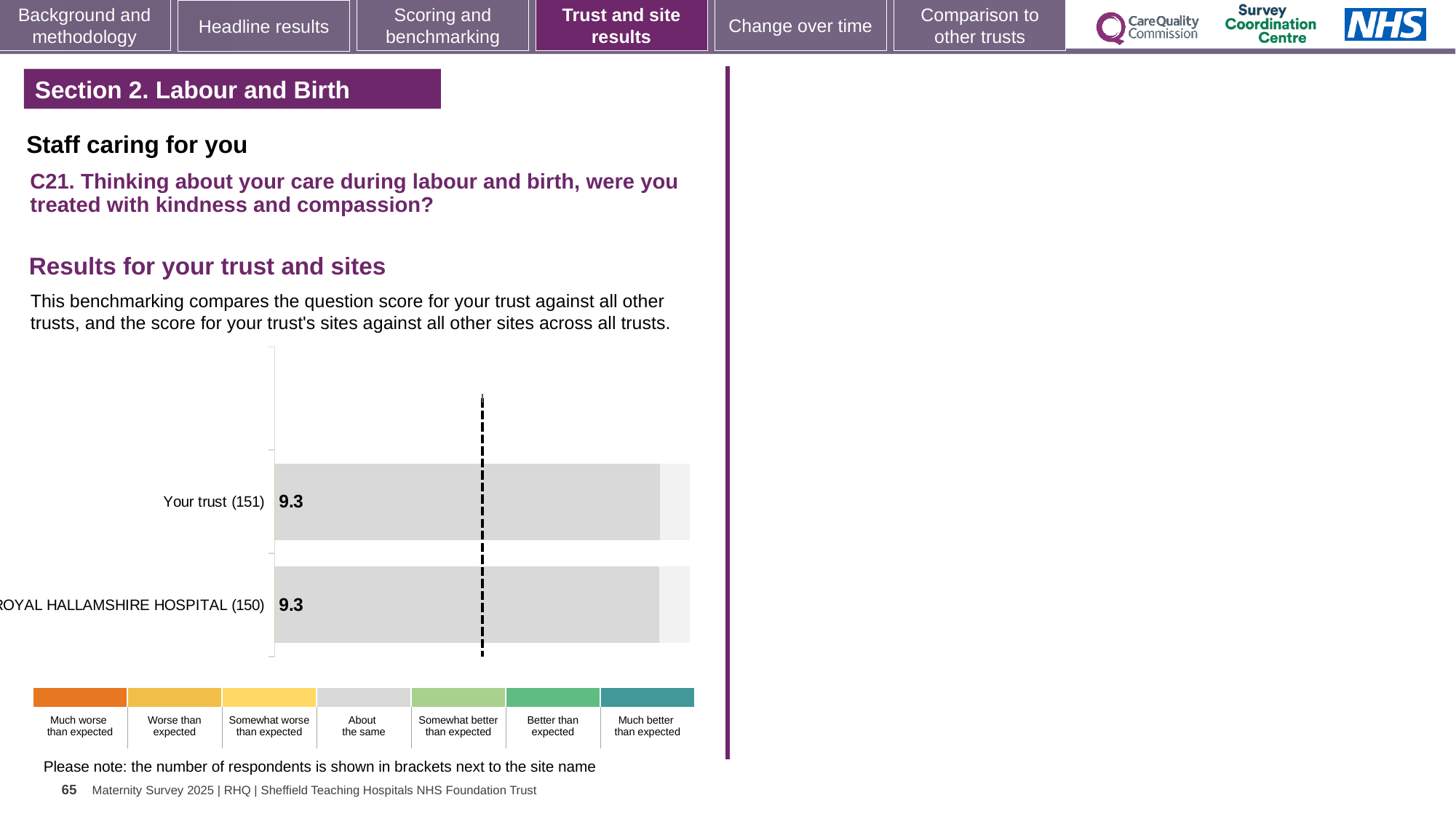
How many respondents are shown in brackets for Your trust? 151 How many respondents are shown in brackets for ROYAL HALLAMSHIRE HOSPITAL? 150 How many bars are plotted in the chart? 2 Which category in the colour key is shown in grey? About the same What kind of chart is shown on the slide? Bar chart What is the difference between the score for Your trust (151) and the score for ROYAL HALLAMSHIRE HOSPITAL (150)? 0 What is the score for ROYAL HALLAMSHIRE HOSPITAL (150)? 9.3 Which survey question does the chart relate to? C21. Thinking about your care during labour and birth, were you treated with kindness and compassion? How many categories does the colour key below the chart list? 7 What is the score for Your trust (151)? 9.3